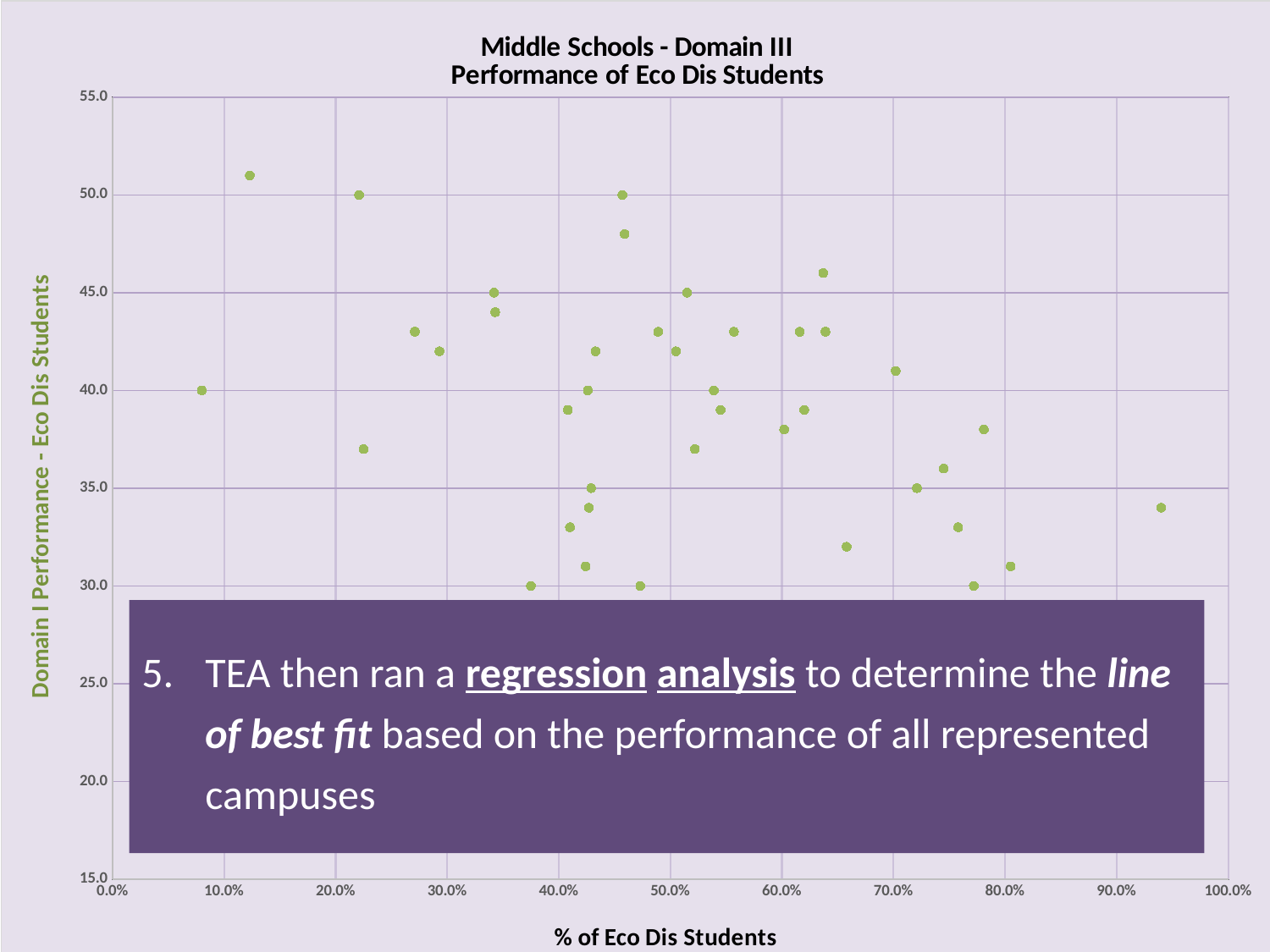
Is the % of Eco Dis Students for the leftmost point greater or less than 10.0%? less Is the Domain I Performance value for the leftmost point (about 8% Eco Dis students) greater or less than 35? greater What is the title of the chart? Middle Schools - Domain III Performance of Eco Dis Students What is the label of the x axis? % of Eco Dis Students Is the Domain I Performance value for the point at about 12% Eco Dis students greater or less than 50? greater What kind of chart is shown on the slide? Scatter chart Which point has the higher Domain I Performance: the one at about 12% Eco Dis students or the one at about 94% Eco Dis students? The one at about 12%